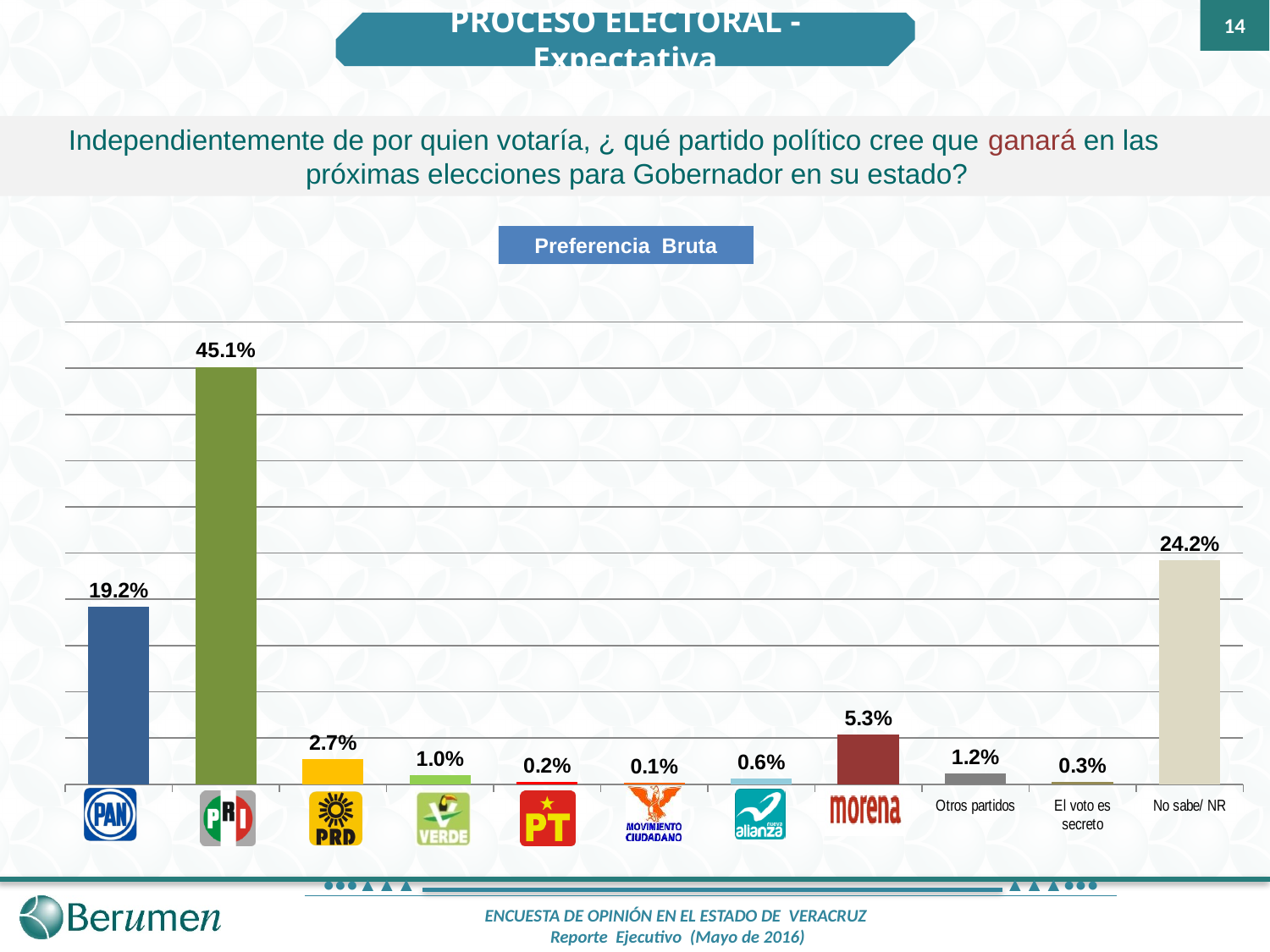
What is the value for PAN? 19.2% What is the value for No sabe/ NR? 24.2% Which is larger, the value for No sabe/ NR or the value for PAN? No sabe/ NR Which category has the lowest value? Movimiento Ciudadano What kind of chart is shown on the slide? Bar chart What is the difference between the values for PRI and PAN? 25.9% Which category has the highest value? PRI What is the value for PRI? 45.1% What is the value for Otros partidos? 1.2% How many categories are shown in the chart? 11 What is the title shown above the chart? Preferencia Bruta What is the value for Morena? 5.3%